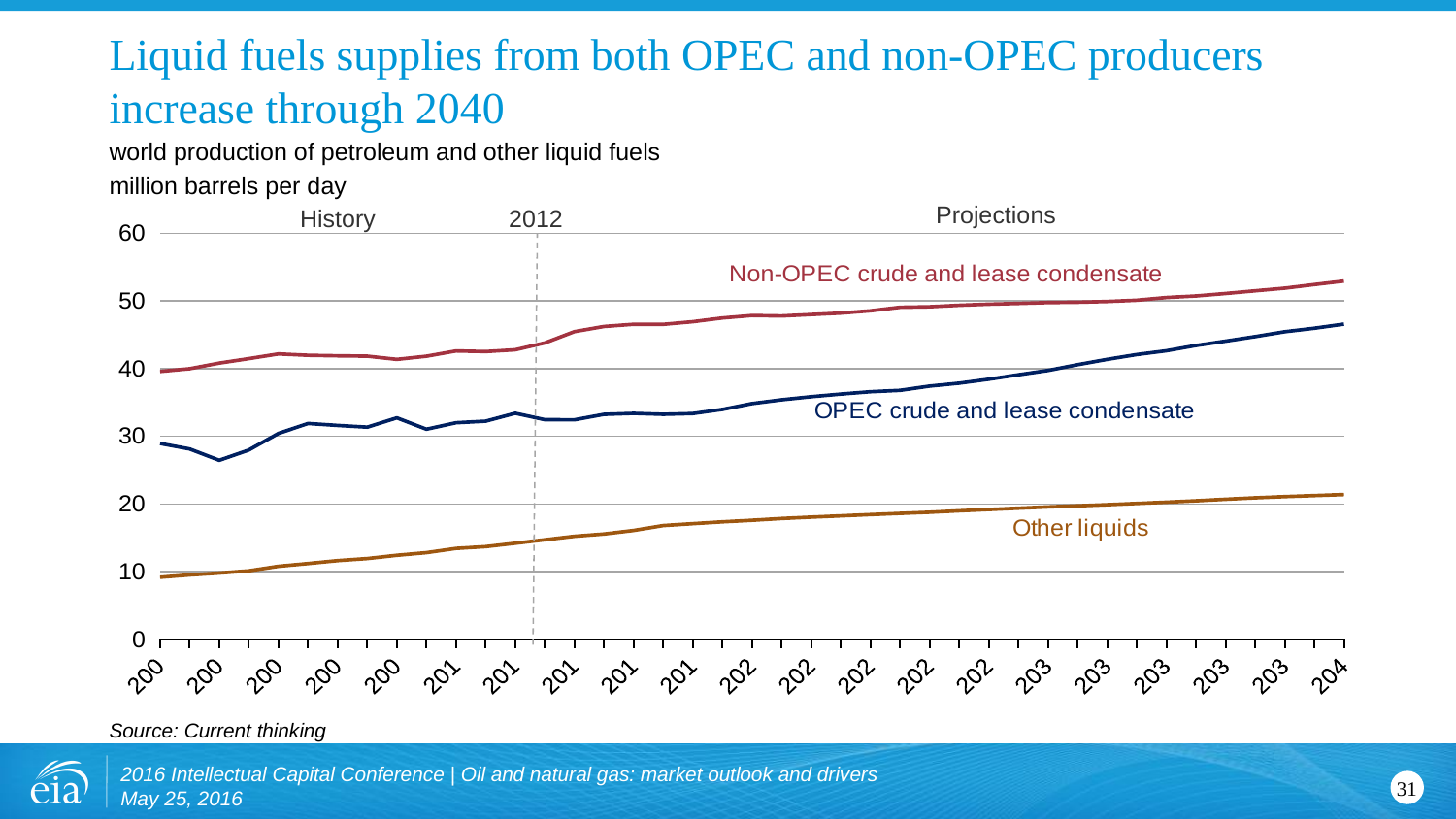
Is the value for OPEC crude and lease condensate in 2040 greater or less than 50? less Is the value for OPEC crude and lease condensate in 2040 greater or less than 40? greater Which series has the highest values across the whole chart? Non-OPEC crude and lease condensate What kind of chart is shown on the slide? line chart In 2040, which is larger: Non-OPEC crude and lease condensate or OPEC crude and lease condensate? Non-OPEC crude and lease condensate Is the value for Non-OPEC crude and lease condensate in 2040 greater or less than 50? greater What unit of measurement is used on the chart? million barrels per day Which series has the lowest values across the whole chart? Other liquids How many series are plotted on the chart? 3 Do the values for OPEC crude and lease condensate rise or fall over the projection period after 2012? rise